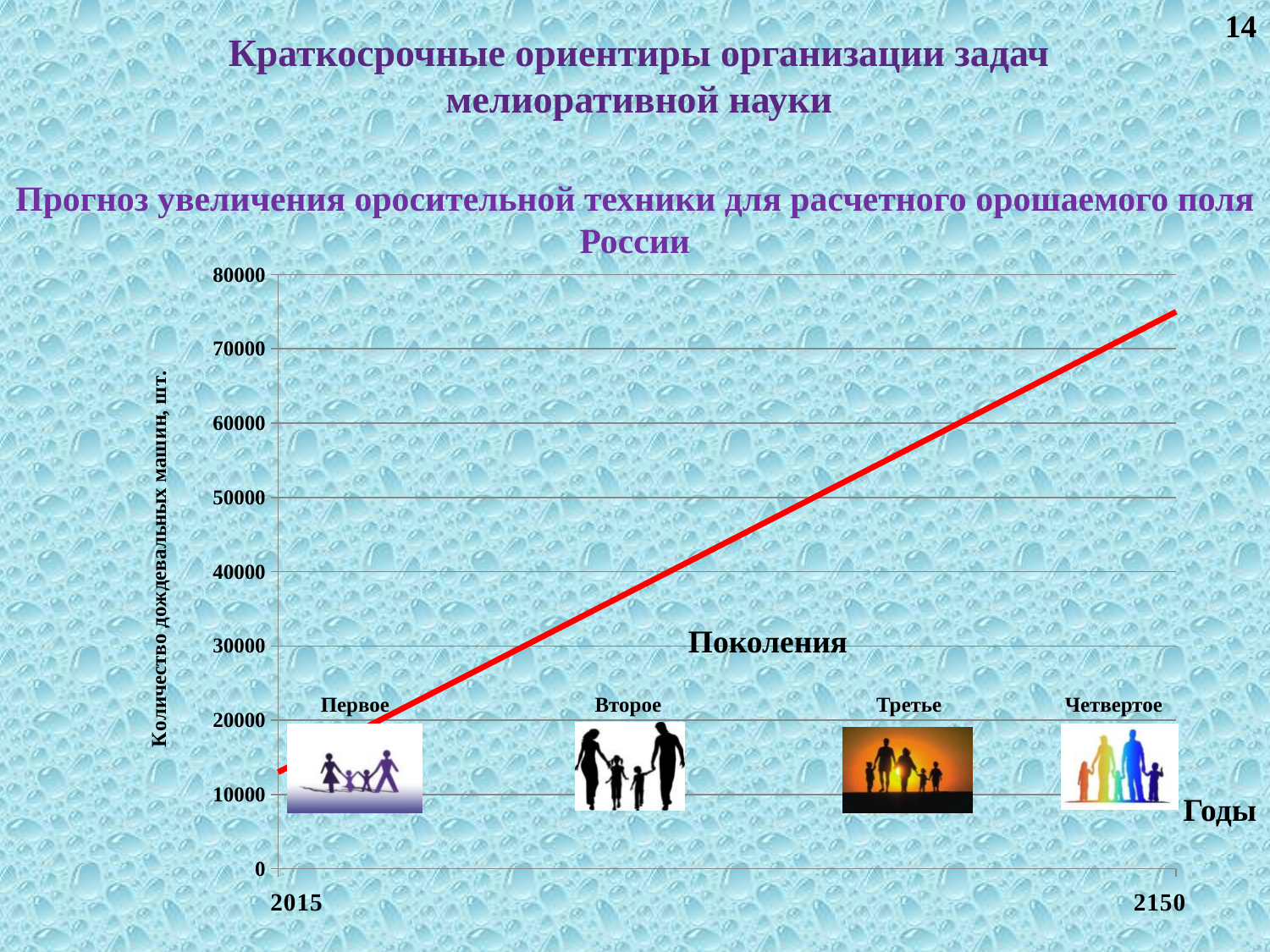
Is the value of the red line at 2015 greater or less than 10000? greater What is the highest tick value shown on the vertical axis? 80000 Is the value of the red line at 2150 greater or less than 70000? greater How many generations (Поколения) are labelled along the chart? 4 What kind of chart is shown on the slide? line chart Is the value of the red line at 2150 greater or less than 80000? less What are the first and last years shown on the horizontal axis? 2015 and 2150 Does the red line rise or fall from 2015 to 2150? rises How many lines are plotted on the chart? 1 What is the label of the vertical axis? Количество дождевальных машин, шт.